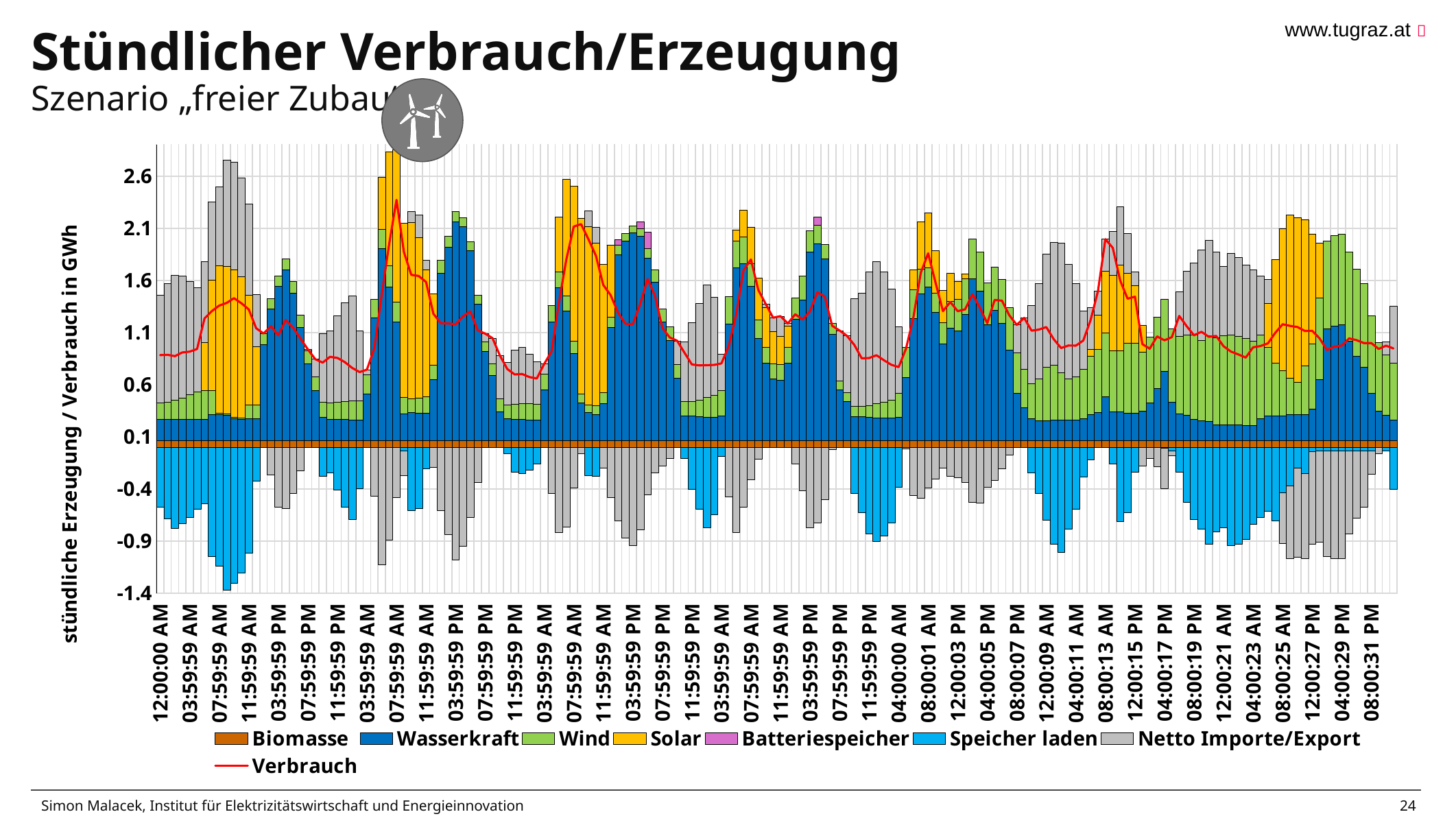
Is the lowest Speicher laden bar greater or less than -0.9? less How many series does the legend list? 8 What is the label of the vertical axis? stündliche Erzeugung / Verbrauch in GWh Is the highest point of the Verbrauch line greater or less than 2.1? greater Does the Verbrauch line rise or fall between 12:00:00 AM and the first 07:59:59 AM label? rise Is the value of the Verbrauch line at 12:00:00 AM greater or less than 1.1? less Which series is drawn as the red line in the chart? Verbrauch What kind of chart is shown on the slide? combination bar and line chart